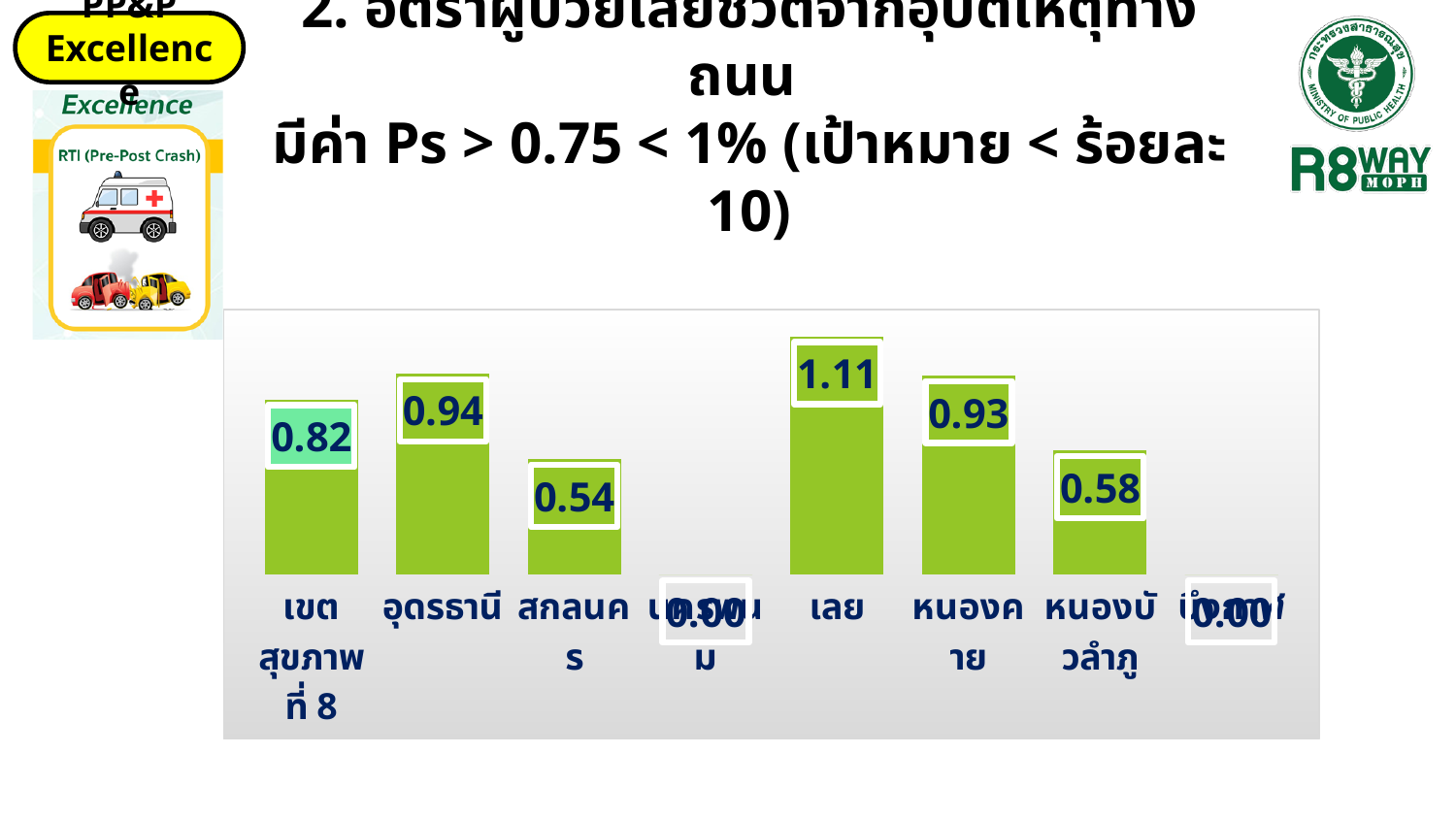
What is the value for หนองบัวลำภู? 0.58 Which is larger, the value for เขตสุขภาพที่ 8 or the value for หนองบัวลำภู? เขตสุขภาพที่ 8 What is the value for เลย? 1.11 What is the value for สกลนคร? 0.54 What is the value for หนองคาย? 0.93 What is the difference between the values for เลย and สกลนคร? 0.57 How many categories are shown on the x axis of the chart? 8 What is the value for เขตสุขภาพที่ 8? 0.82 What kind of chart is shown on the slide? bar chart Which category has the highest value? เลย What is the difference between the values for อุดรธานี and เขตสุขภาพที่ 8? 0.12 What is the value for อุดรธานี? 0.94